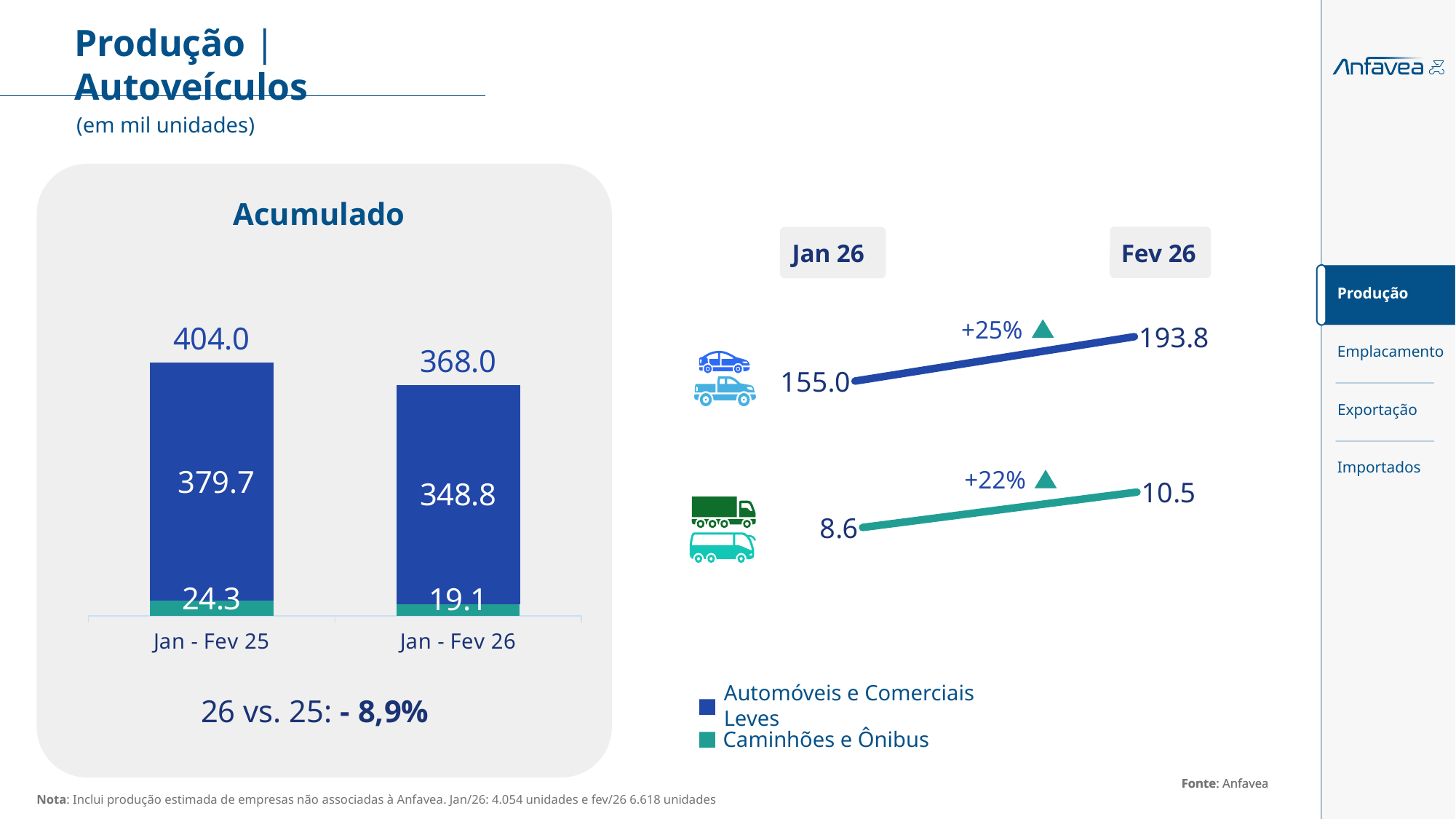
In the Acumulado chart, is the Caminhões e Ônibus value larger in Jan - Fev 25 or Jan - Fev 26? Jan - Fev 25 In the Acumulado chart, what is the difference between the Jan - Fev 25 total and the Jan - Fev 26 total? 36.0 In the Acumulado chart, what percentage change is shown for 26 vs. 25? - 8,9% In the chart on the right, what is the value for Automóveis e Comerciais Leves in Fev 26? 193.8 In the chart on the right, what is the difference between the Fev 26 and Jan 26 values for Automóveis e Comerciais Leves? 38.8 In the chart on the right, does the Caminhões e Ônibus line rise or fall from Jan 26 to Fev 26? Rise In the Acumulado chart, what is the total of the Jan - Fev 26 stacked bar? 368.0 What kind of chart is the Acumulado chart? Stacked bar chart In the chart on the right, what is the value for Caminhões e Ônibus in Jan 26? 8.6 In the Acumulado chart, what is the value for Automóveis e Comerciais Leves in Jan - Fev 25? 379.7 How many series does the legend list? 2 In the Acumulado chart, what is the value for Caminhões e Ônibus in Jan - Fev 26? 19.1